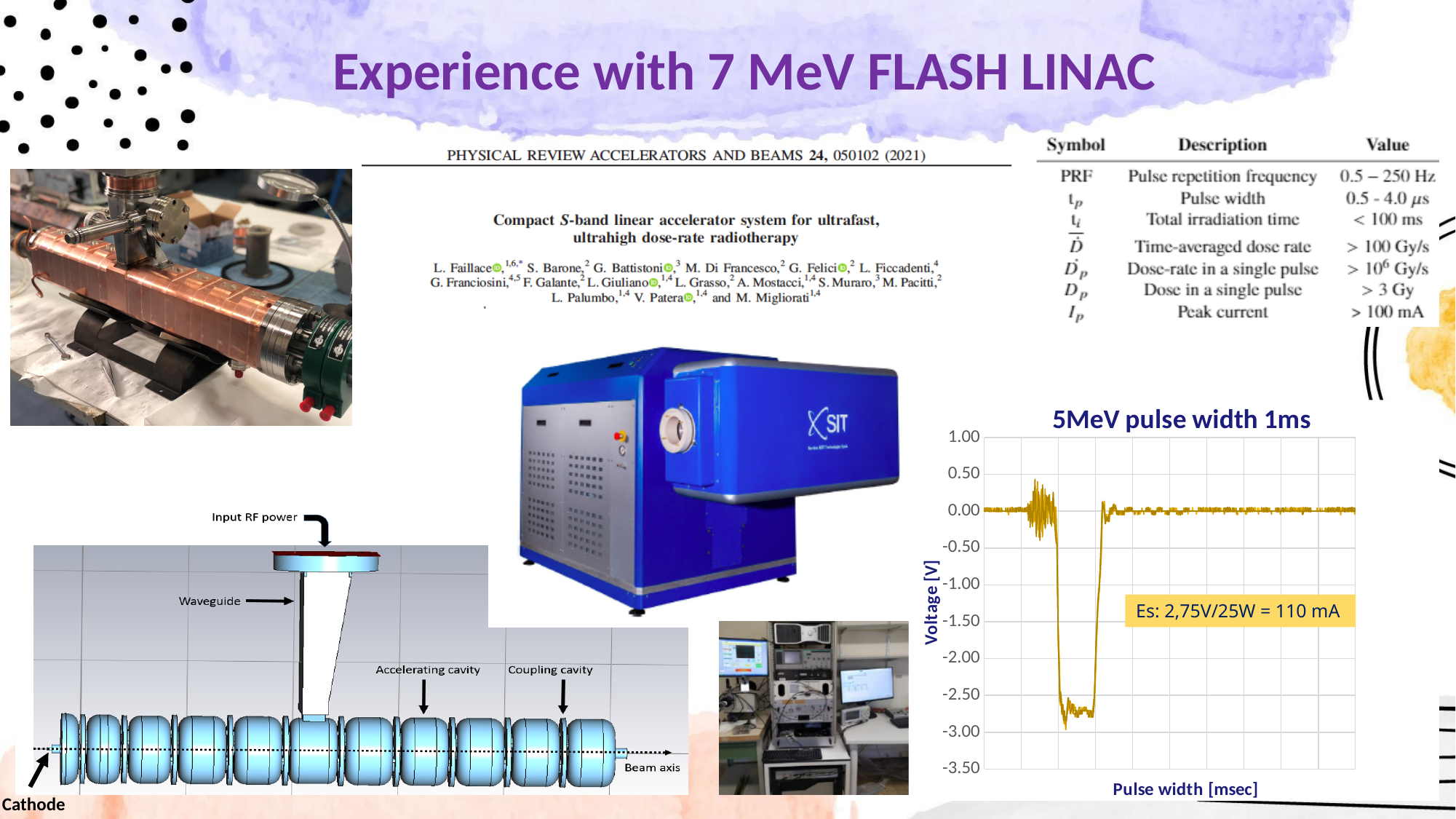
What is the highest tick value shown on the vertical axis of the chart titled '5MeV pulse width 1ms'? 1.00 What is the lowest tick value shown on the vertical axis of the chart titled '5MeV pulse width 1ms'? -3.50 In the chart titled '5MeV pulse width 1ms', is the voltage level before the pulse greater or less than -0.50? greater In the chart titled '5MeV pulse width 1ms', is the voltage after the pulse ends greater or less than -1.00? greater What kind of chart is shown at the bottom right of the slide? line chart What is the title of the chart at the bottom right of the slide? 5MeV pulse width 1ms What is the label of the vertical axis of the chart titled '5MeV pulse width 1ms'? Voltage [V] In the chart titled '5MeV pulse width 1ms', is the voltage during the pulse plateau greater or less than -2.00? less